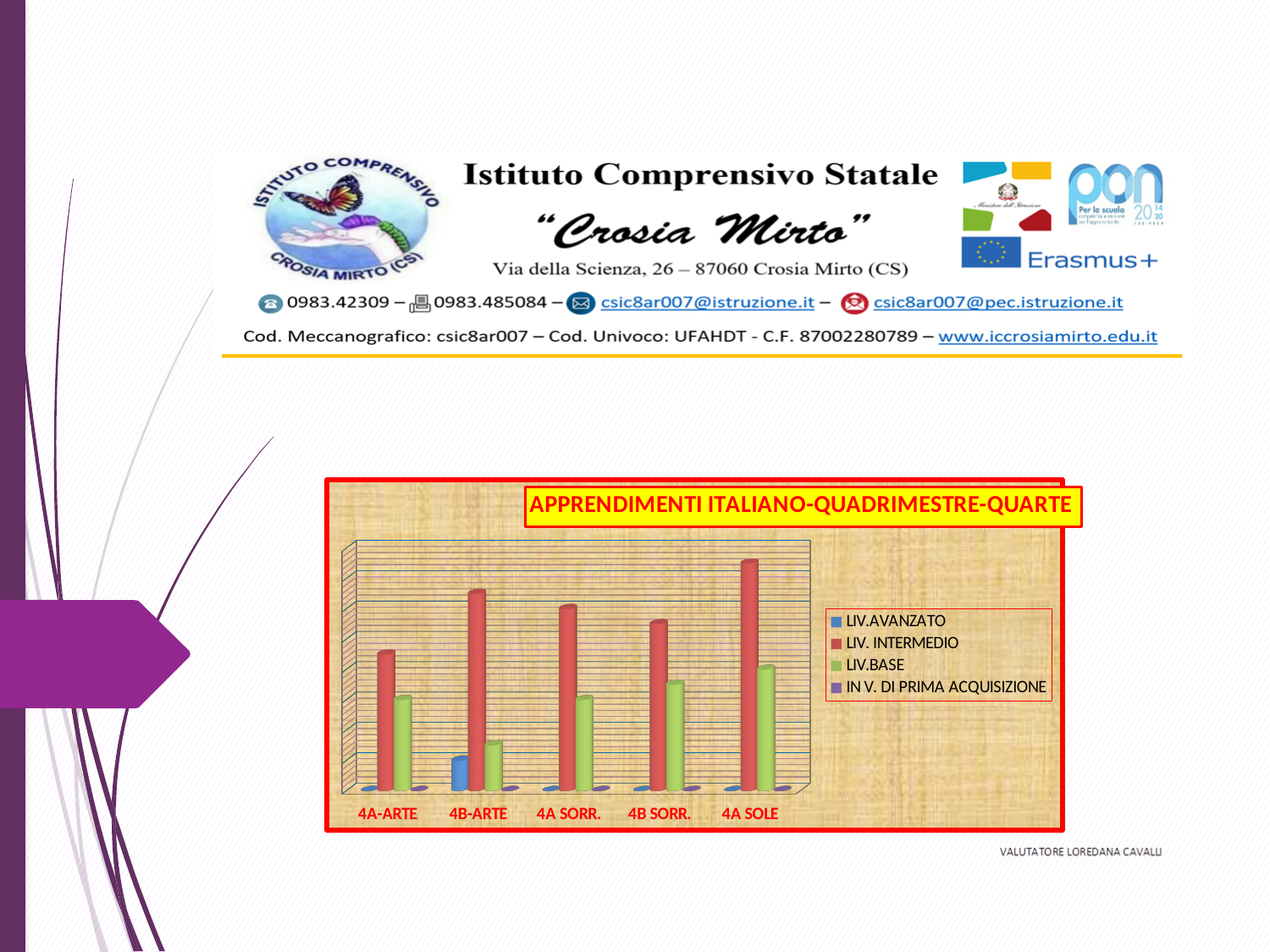
What kind of chart is shown on the slide? bar chart Which class has the highest LIV.BASE bar? 4A SOLE How many classes (categories) are shown on the x axis of the chart? 5 Which is larger, the LIV. INTERMEDIO bar for 4B-ARTE or for 4A SORR.? 4B-ARTE Which is the only class with a visible LIV.AVANZATO bar? 4B-ARTE What is the title of the chart? APPRENDIMENTI ITALIANO-QUADRIMESTRE-QUARTE Which class has the lowest LIV. INTERMEDIO bar? 4A-ARTE Which class has the lowest LIV.BASE bar? 4B-ARTE Which is larger for 4A-ARTE, the LIV. INTERMEDIO bar or the LIV.BASE bar? LIV. INTERMEDIO How many series does the chart legend list? 4 Which class has the highest LIV. INTERMEDIO bar? 4A SOLE Which is larger, the LIV.BASE bar for 4B SORR. or for 4A SORR.? 4B SORR.